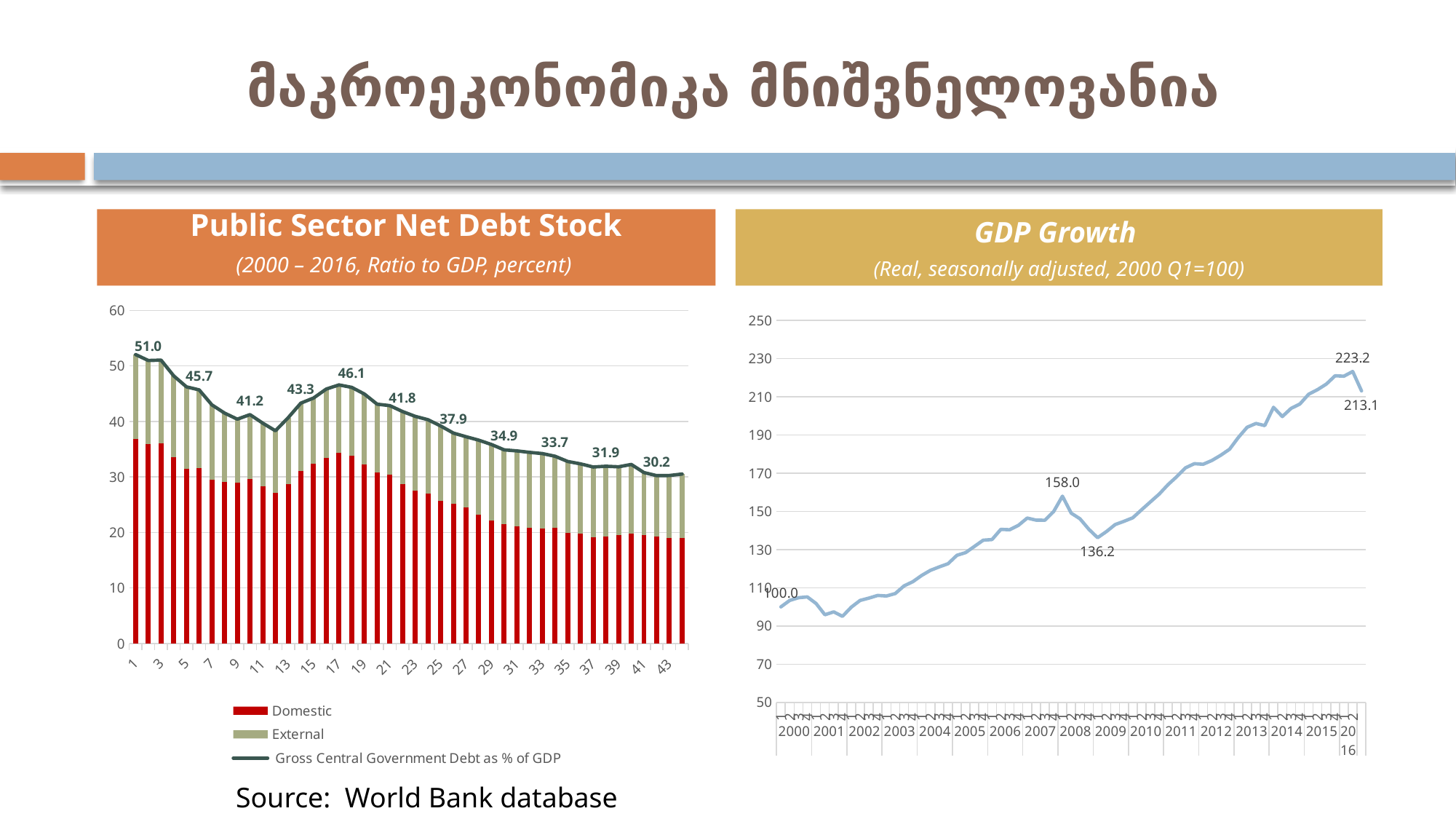
In the GDP Growth chart, what is the difference between the labeled values 158.0 and 136.2? 21.8 In the Public Sector Net Debt Stock chart, which labeled value is larger, 46.1 or 43.3? 46.1 In the Public Sector Net Debt Stock chart, what is the lowest labeled value on the Gross Central Government Debt line? 30.2 How many series does the legend of the Public Sector Net Debt Stock chart list? 3 What kind of chart is the GDP Growth chart? line chart In the GDP Growth chart, what is the labeled value at the start of the series in 2000? 100.0 In the GDP Growth chart, does the line generally rise or fall from 2000 to 2016? rise In the Public Sector Net Debt Stock chart, what is the highest labeled value on the Gross Central Government Debt line? 51.0 In the GDP Growth chart, is the lowest point of the line around 2001 greater or less than 100? less In the GDP Growth chart, what is the difference between the labeled peak of 223.2 and the final labeled value of 213.1? 10.1 In the Public Sector Net Debt Stock chart, what is the difference between the first labeled value (51.0) and the last labeled value (30.2)? 20.8 In the GDP Growth chart, what is the highest labeled value on the line? 223.2